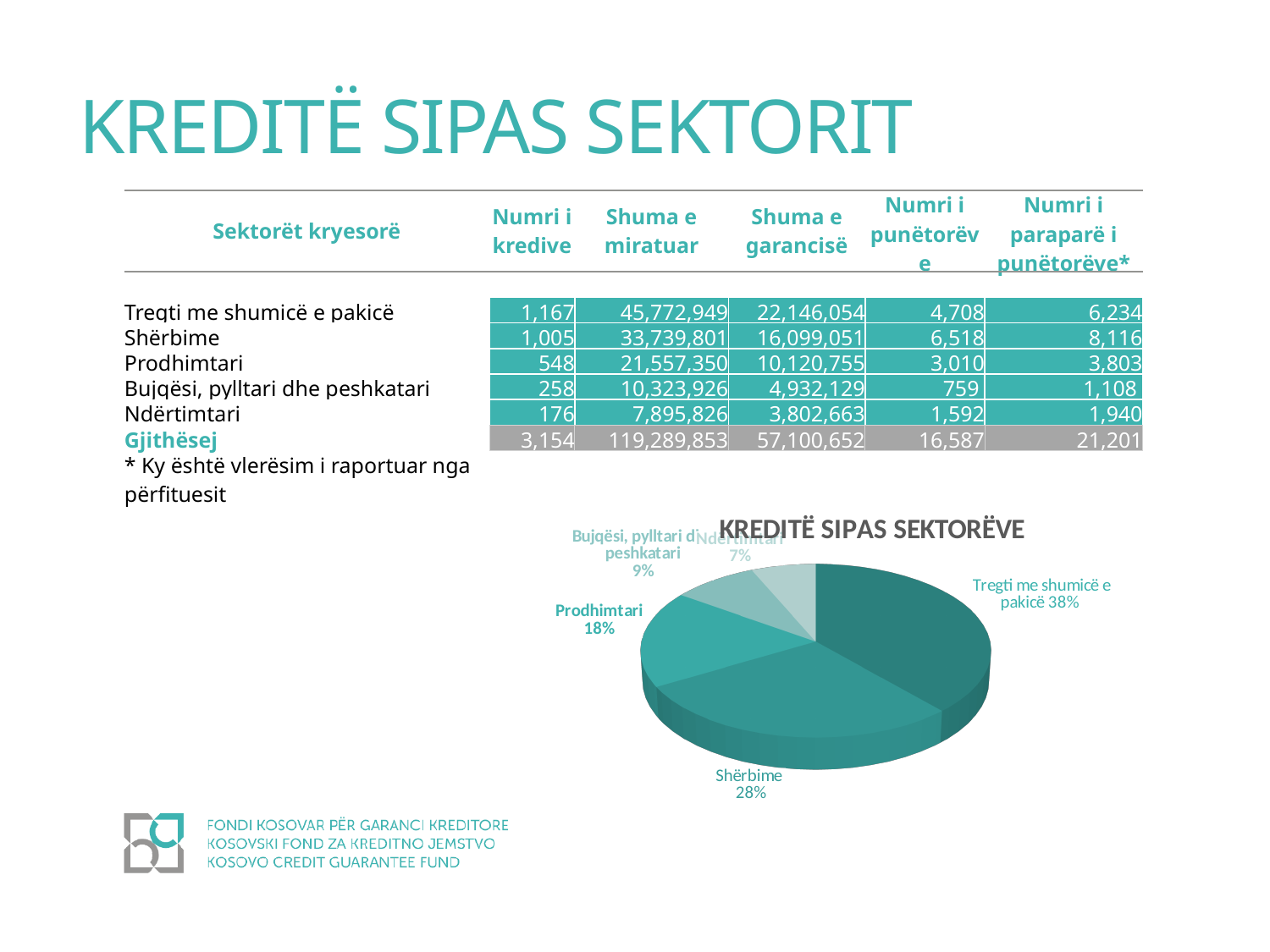
How many slices does the pie chart have? 5 Which sector has the largest slice of the pie? Tregti me shumicë e pakicë What is the combined share of the Shërbime and Prodhimtari slices? 46% Which sector has the smallest slice of the pie? Ndërtimtari What type of chart is shown on the slide? Pie chart What is the title of the pie chart? KREDITË SIPAS SEKTORËVE Which slice is larger, Prodhimtari or Bujqësi, pylltari dhe peshkatari? Prodhimtari What share of the pie does Tregti me shumicë e pakicë hold? 38% What is the difference in percentage points between the Tregti me shumicë e pakicë slice and the Shërbime slice? 10 What share of the pie does Shërbime hold? 28% What share of the pie does Bujqësi, pylltari dhe peshkatari hold? 9%